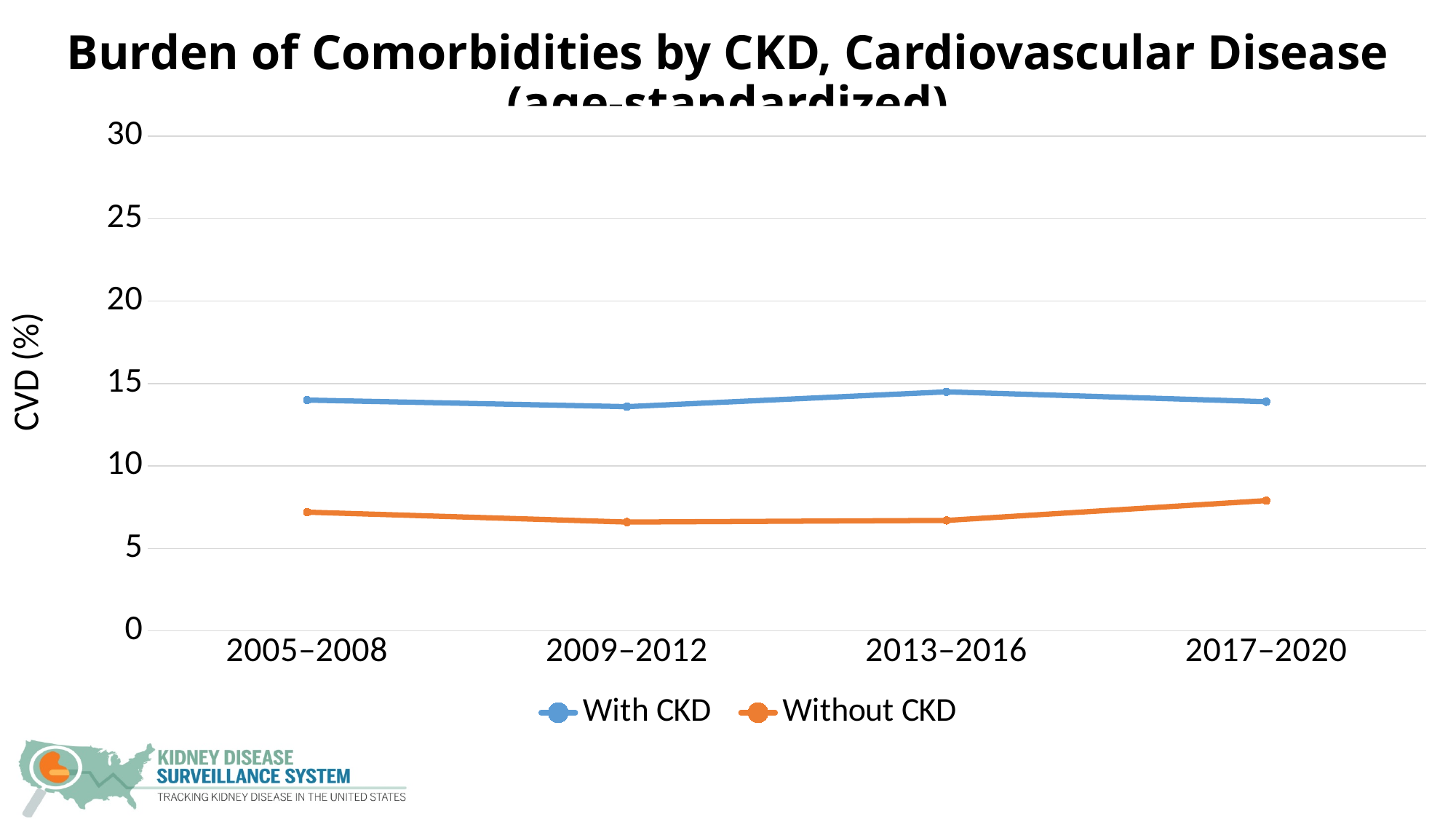
In which period is the Without CKD value highest? 2017–2020 Is the With CKD value for 2005–2008 greater or less than 15? less Which series has the higher value in 2013–2016, With CKD or Without CKD? With CKD Is the Without CKD value for 2009–2012 greater or less than 5? greater What is the label on the y axis? CVD (%) Which series has the lower value in 2005–2008, With CKD or Without CKD? Without CKD How many series does the legend list? 2 What kind of chart is shown on the slide? line chart How many time periods are shown on the x axis? 4 Is the Without CKD value for 2017–2020 greater or less than 10? less Does the Without CKD line rise or fall from 2013–2016 to 2017–2020? rise